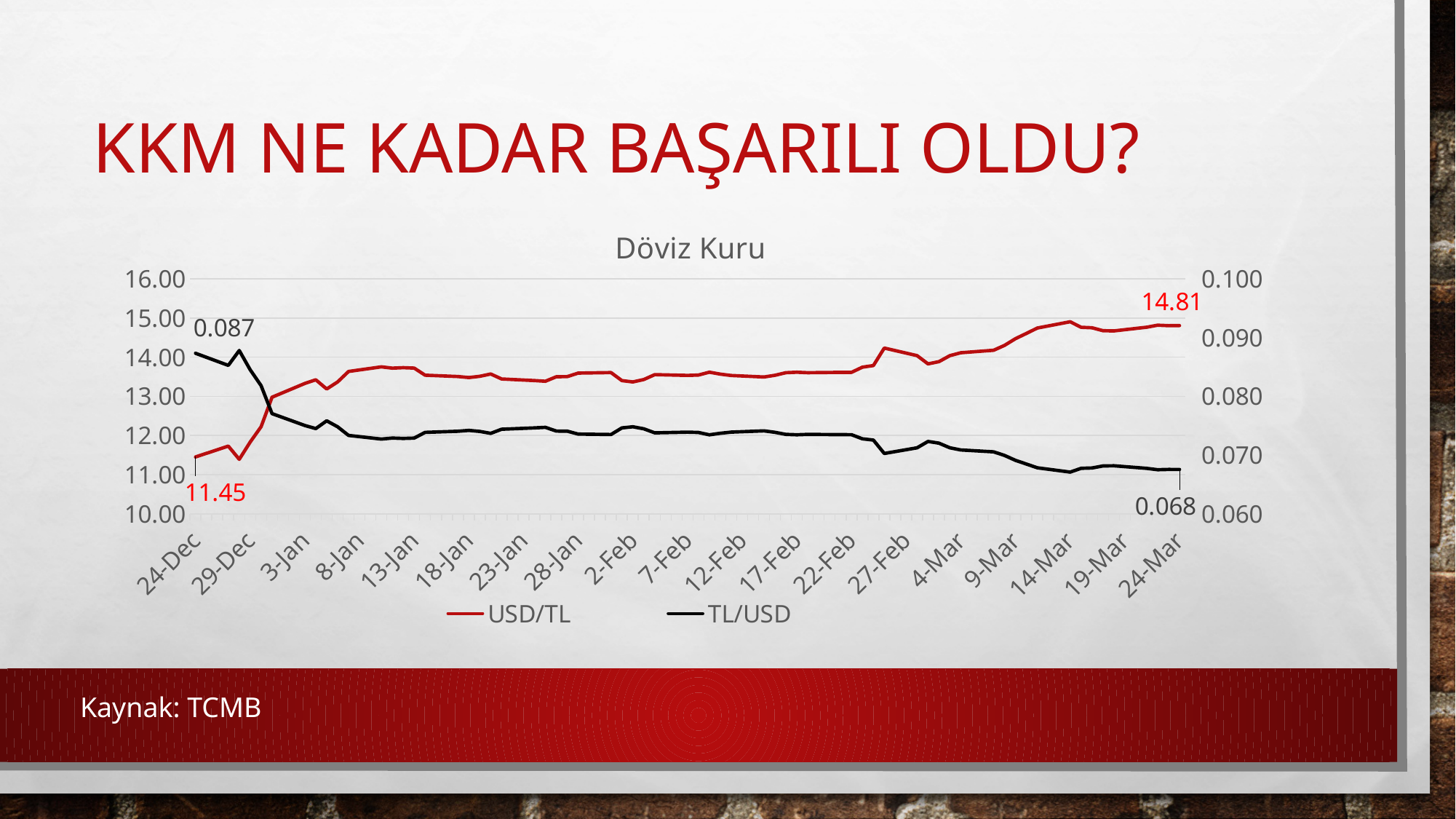
What kind of chart is shown on the slide? line chart Is the USD/TL value on 13-Jan greater or less than 13.00? greater Does the USD/TL series rise or fall overall from 24-Dec to 24-Mar? rise By how much did the TL/USD value decrease from 24-Dec to 24-Mar? 0.019 What is the USD/TL value on 24-Dec? 11.45 What is the TL/USD value on 24-Mar? 0.068 How many series does the legend of the chart list? 2 What is the USD/TL value on 24-Mar? 14.81 Does the TL/USD series rise or fall overall from 24-Dec to 24-Mar? fall What is the TL/USD value on 24-Dec? 0.087 What is the title of the chart? Döviz Kuru By how much did the USD/TL value increase from 24-Dec to 24-Mar? 3.36